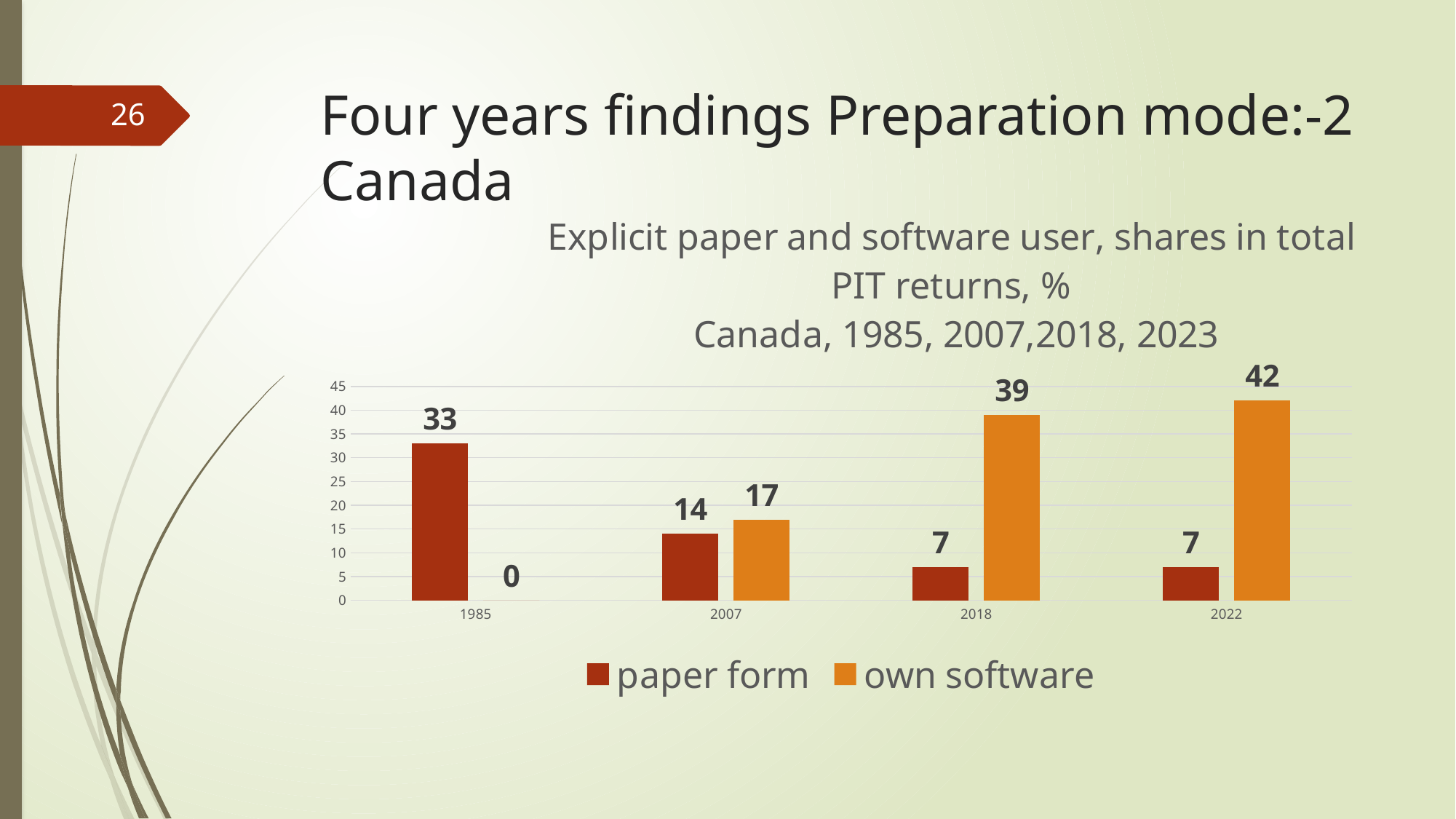
What is the value for own software in 1985? 0 In 2007, which is larger: paper form or own software? own software Which year has the lowest value for paper form? 2018 and 2022 What is the value for own software in 2022? 42 Does the value for paper form rise or fall from 1985 to 2022? fall What is the value for paper form in 1985? 33 What kind of chart is shown? bar chart Is the value for own software in 2018 greater or less than 35? greater Which year has the highest value for own software? 2022 What is the difference between own software and paper form in 2018? 32 How many years are shown on the x axis? 4 How many series does the legend list? 2